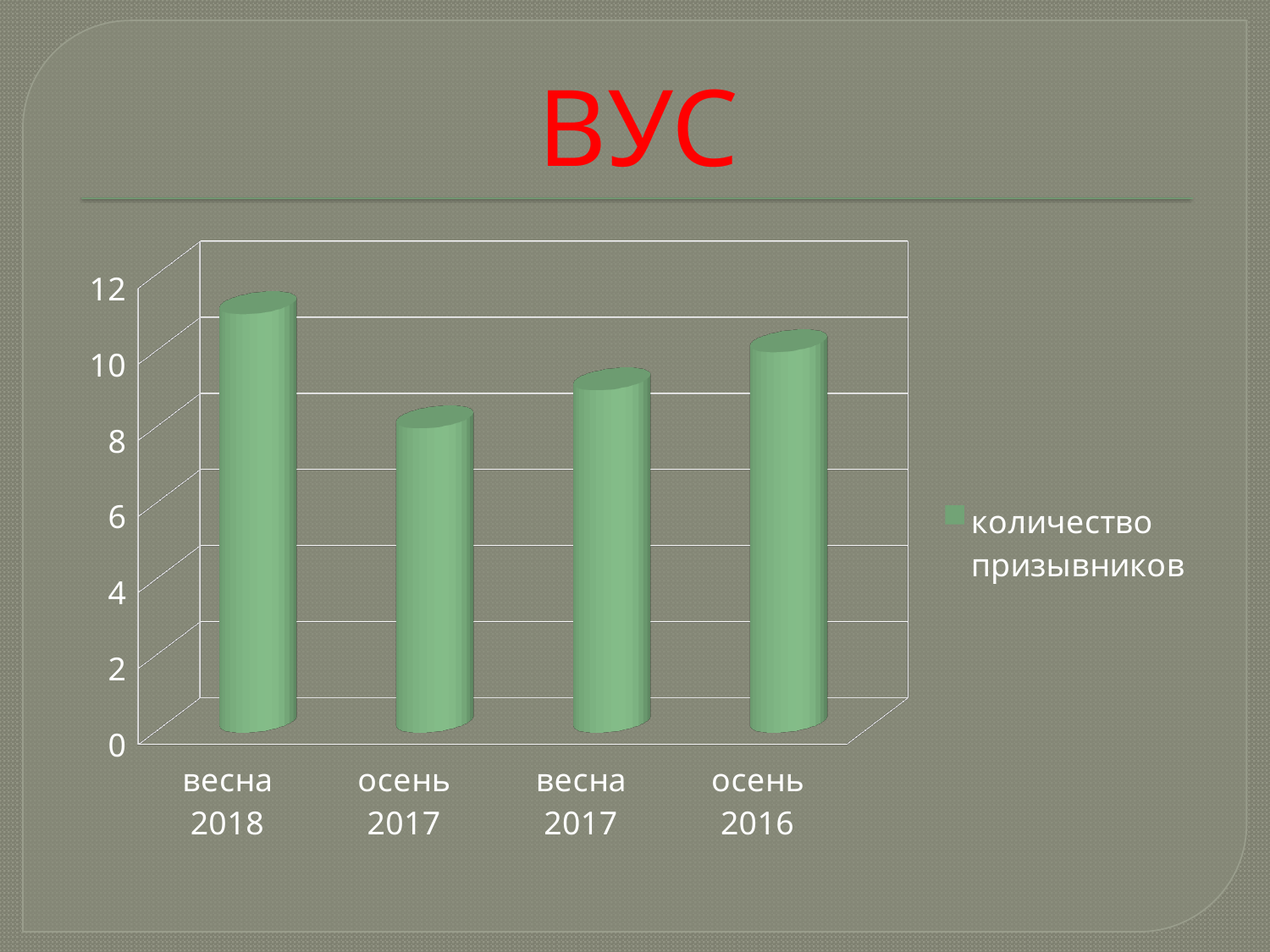
Does the value rise or fall from весна 2018 to осень 2017? fall Which category has the highest value? весна 2018 Is the value for осень 2017 greater or less than 10? less How many categories are shown on the x axis? 4 What is the title of the chart? ВУС How many series does the legend list? 1 Is the value for осень 2016 greater or less than 8? greater Is the value for весна 2018 greater or less than 10? greater What kind of chart is shown on the slide? bar chart Which is larger, the value for весна 2018 or the value for осень 2017? весна 2018 What series name does the legend show? количество призывников Which category has the lowest value? осень 2017